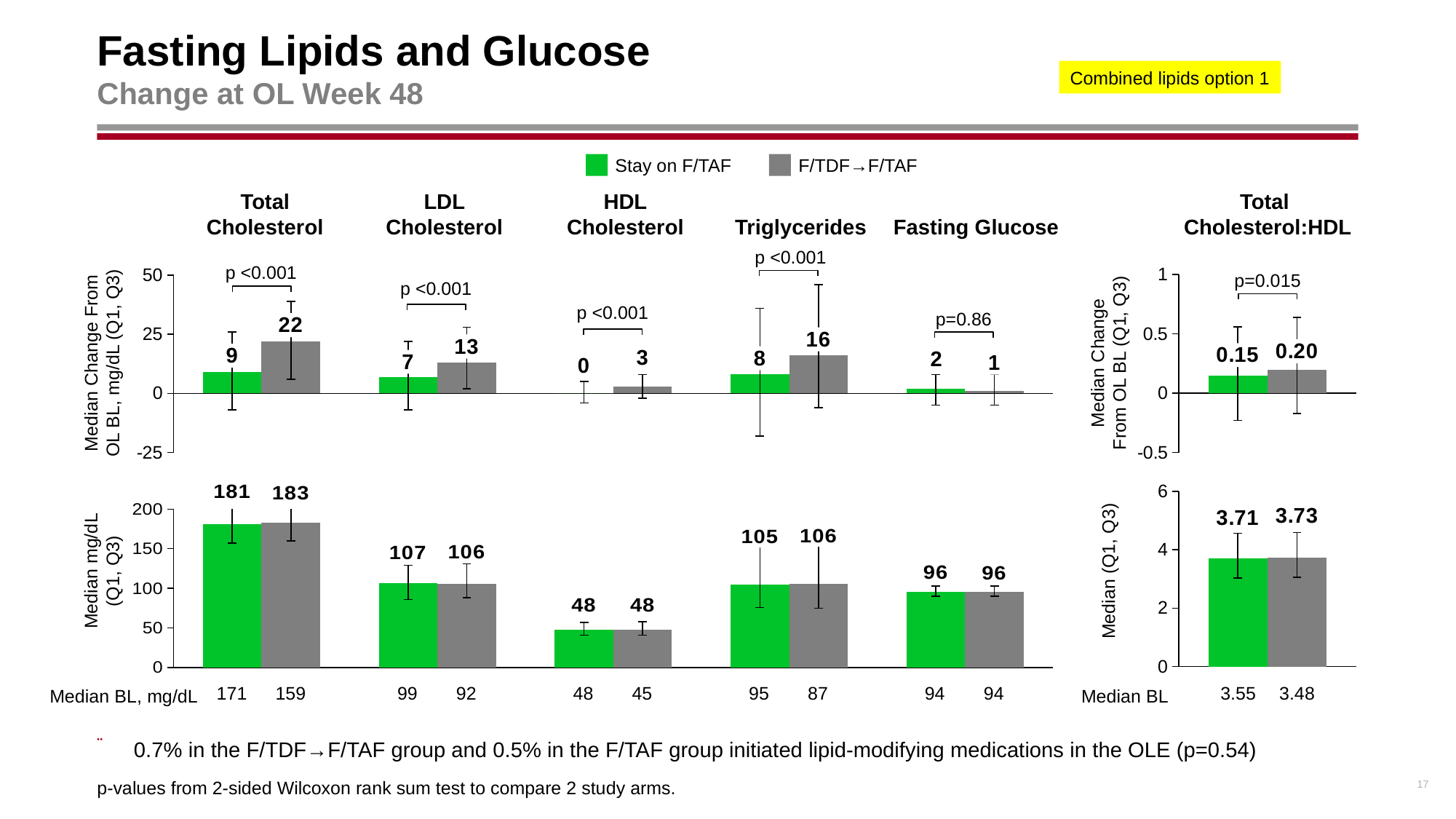
In the bottom-left chart of median mg/dL, what is the difference between the Stay on F/TAF and F/TDF→F/TAF values for LDL Cholesterol? 1 In the top-left chart of median change from OL baseline (mg/dL), what is the value for the F/TDF→F/TAF group for Total Cholesterol? 22 In the top-left chart of median change from OL baseline (mg/dL), which group has the larger value for Fasting Glucose? Stay on F/TAF In the top-right chart of median change from OL baseline for Total Cholesterol:HDL, what is the value for the F/TDF→F/TAF group? 0.20 In the top-left chart of median change from OL baseline (mg/dL), what is the value for the Stay on F/TAF group for Triglycerides? 8 In the bottom-right chart of median Total Cholesterol:HDL, what is the value for the Stay on F/TAF group? 3.71 In the bottom-left chart of median mg/dL, what is the value for the Stay on F/TAF group for Total Cholesterol? 181 In the bottom-left chart of median mg/dL, which category has the lowest values? HDL Cholesterol What kind of chart is the bottom-left chart of median mg/dL? Bar chart In the top-left chart of median change from OL baseline (mg/dL), what is the difference between the F/TDF→F/TAF and Stay on F/TAF values for LDL Cholesterol? 6 How many series does the legend list? 2 In the top-left chart of median change from OL baseline (mg/dL), which category has the highest value for the F/TDF→F/TAF group? Total Cholesterol